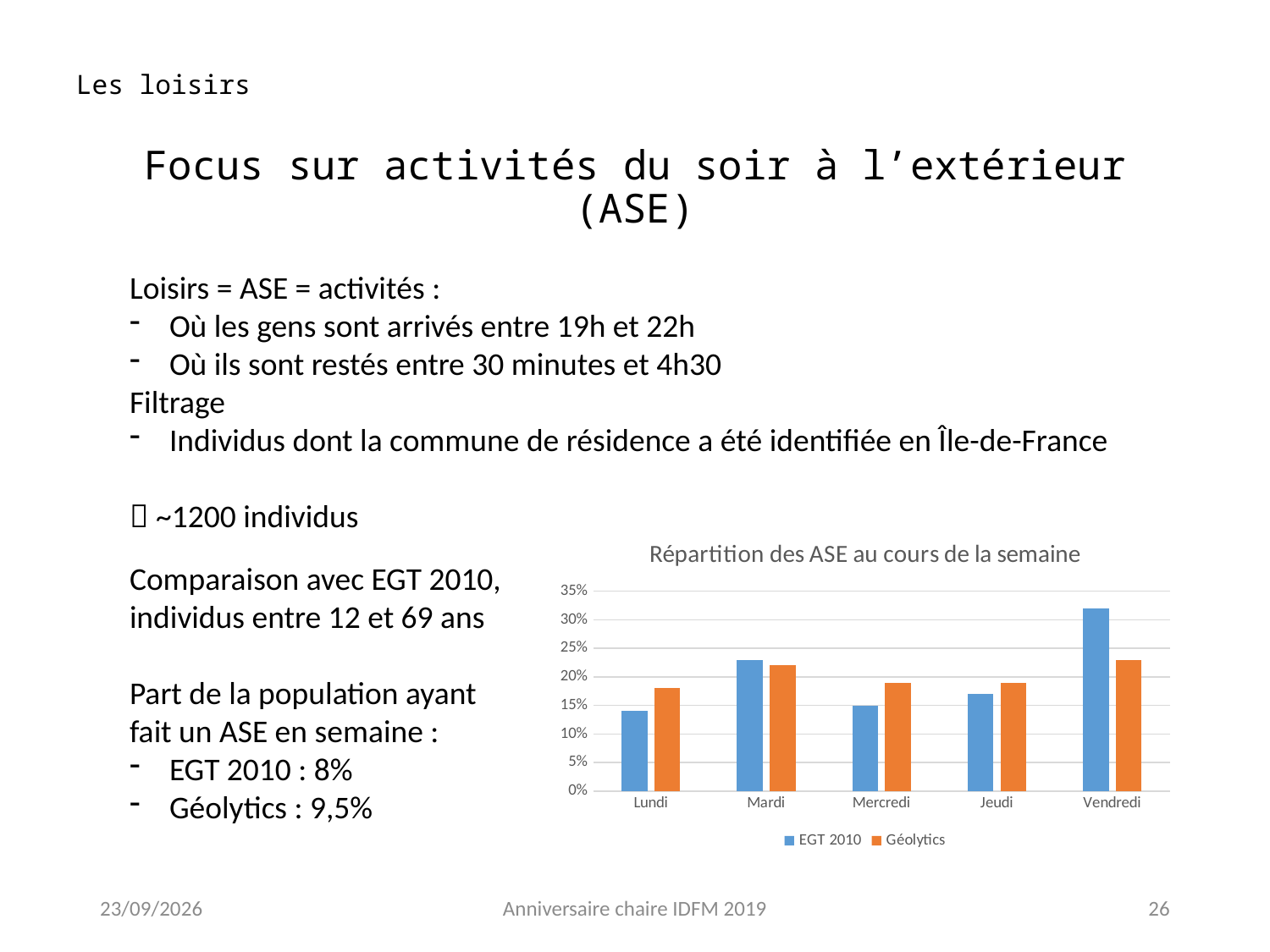
For Lundi, which series has the larger value, EGT 2010 or Géolytics? Géolytics For Vendredi, which series has the larger value, EGT 2010 or Géolytics? EGT 2010 Which day has the highest value for the EGT 2010 series? Vendredi Which series is shown in orange in the chart? Géolytics Is the EGT 2010 value for Lundi greater or less than 20%? less What is the title of the chart? Répartition des ASE au cours de la semaine How many days (categories) are shown on the x axis of the chart? 5 Is the EGT 2010 value for Vendredi greater or less than 30%? greater How many series does the chart legend list? 2 What kind of chart is shown on the slide? bar chart Is the Géolytics value for Mardi greater or less than 20%? greater